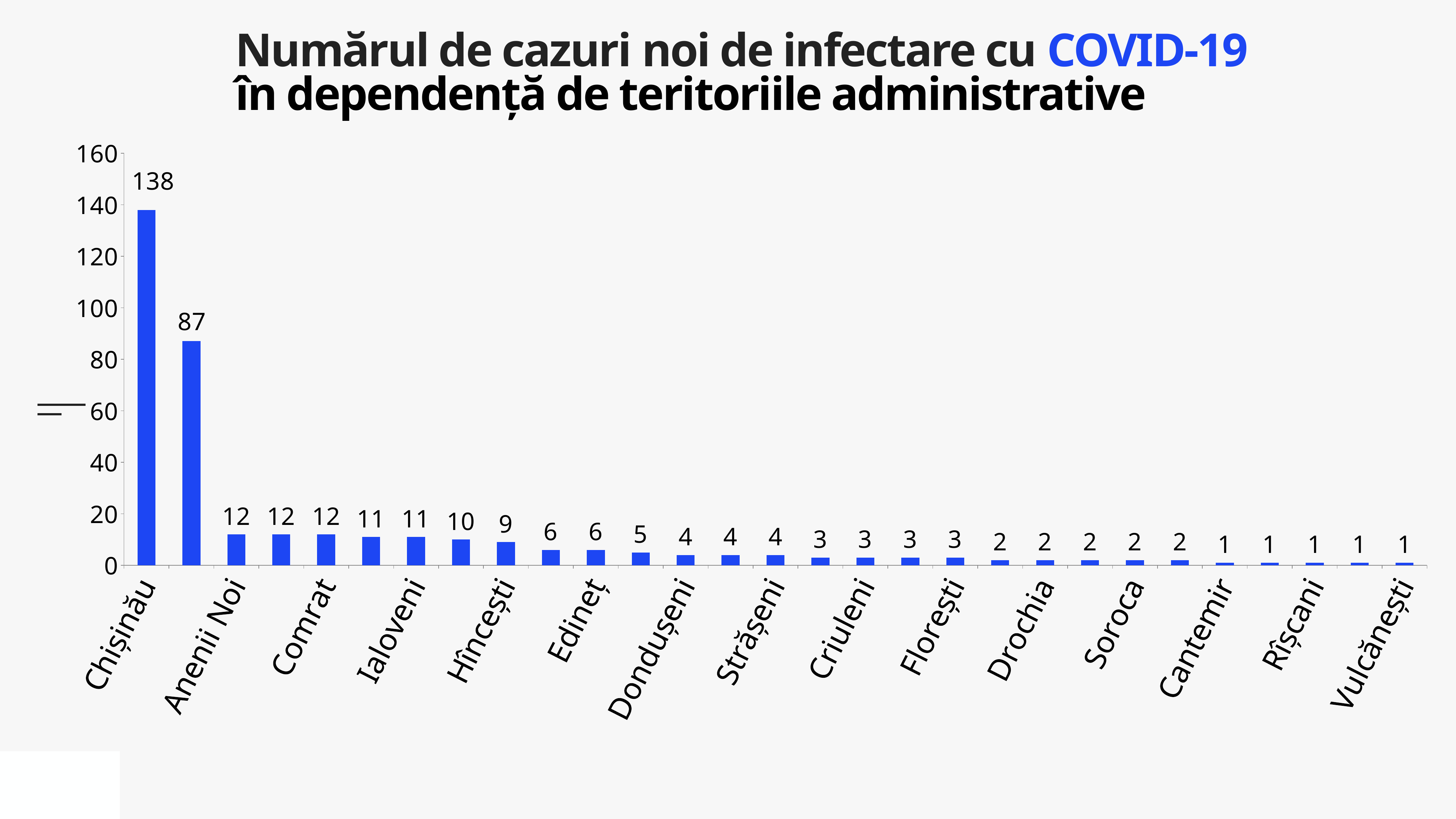
What is the value for Chișinău? 138 What kind of chart is shown on the slide? bar chart What is the value of the second-tallest bar? 87 Do the values rise or fall moving from left to right along the x axis? fall Which category has the highest value? Chișinău What is the highest tick value shown on the vertical axis? 160 What is the value for Vulcănești? 1 Is the value for Anenii Noi greater or less than 20? less Which is larger, the value for Chișinău or the value for Comrat? Chișinău How many bars are plotted in the chart? 29 Is the value for Chișinău greater or less than 120? greater What is the difference between the tallest bar and the second-tallest bar? 51